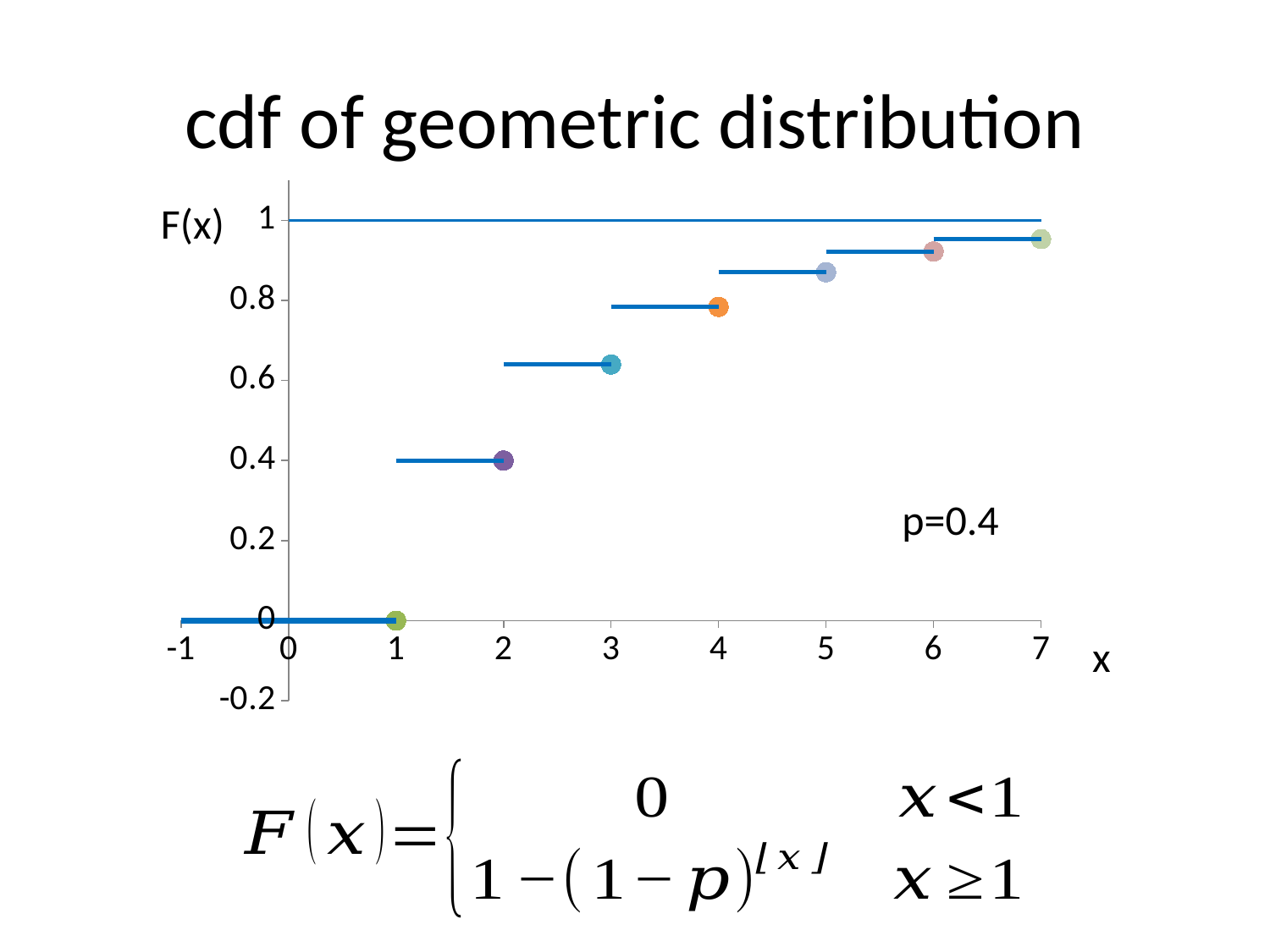
Is the value of F(x) at x=5 greater or less than 0.8? greater Do the plotted values of F(x) rise or fall as x increases? rise What value of p is stated on the chart? p=0.4 Is F(x) larger at x=6 or at x=3? x=6 What is the title of the chart? cdf of geometric distribution How many plotted points (dots) are shown on the chart? 7 Which plotted point has the highest F(x) value? x=7 What is the value of F(x) at the plotted point x=1? 0 What is the value of F(x) at the plotted point x=2? 0.4 Is the value of F(x) at x=7 greater or less than 1? less Is the value of F(x) at x=3 greater or less than 0.6? greater